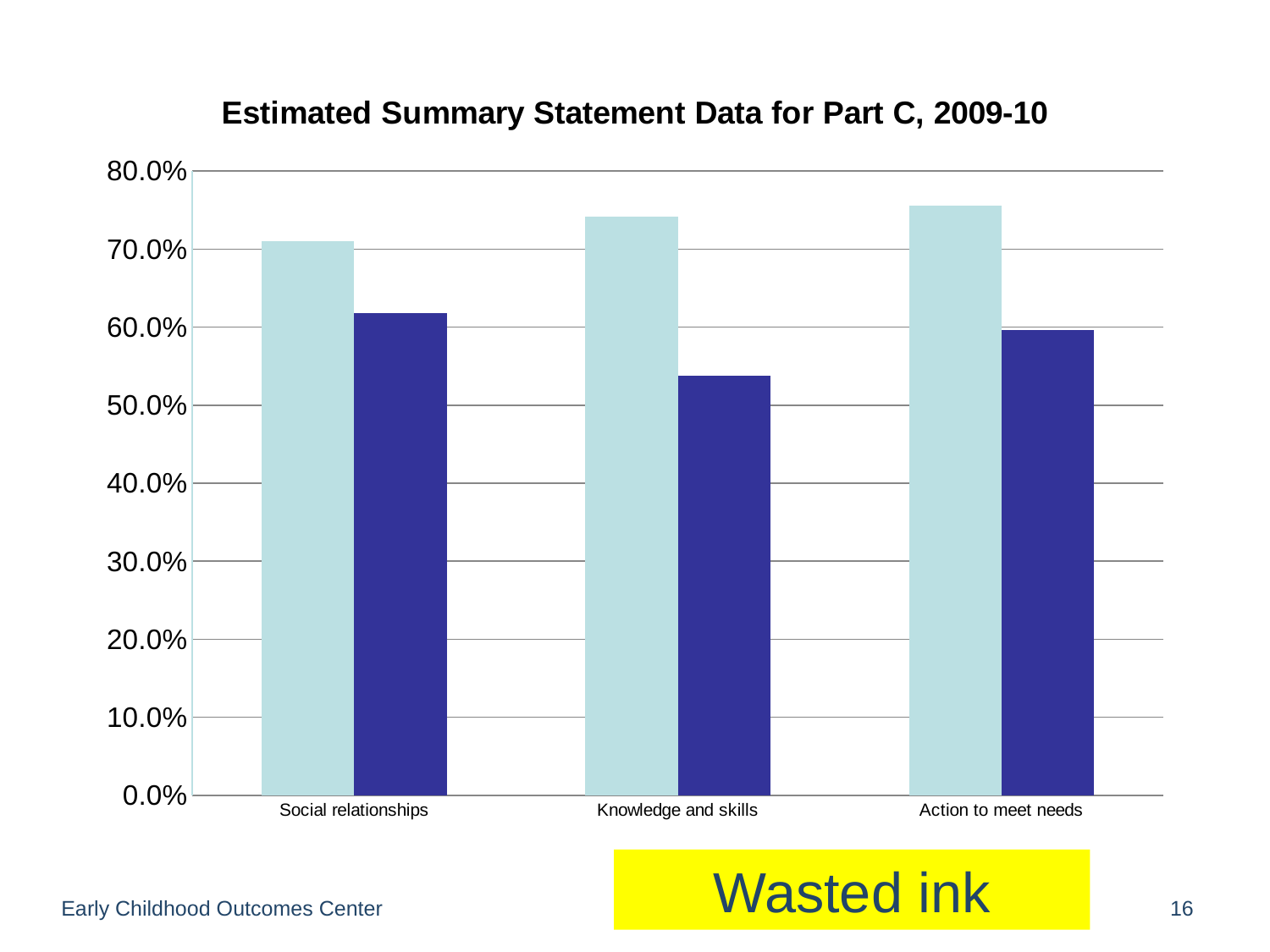
Is the light blue bar for Knowledge and skills greater or less than 70.0%? greater What is the title of the chart? Estimated Summary Statement Data for Part C, 2009-10 For Knowledge and skills, which bar is taller, the light blue bar or the dark blue bar? The light blue bar Is the dark blue bar for Action to meet needs greater or less than 50.0%? greater How many bars are plotted for each category in the chart? 2 Do the light blue bars rise or fall from Social relationships to Action to meet needs? Rise Is the light blue bar for Action to meet needs greater or less than 70.0%? greater What kind of chart is shown on the slide? Bar chart Which category has the lowest dark blue bar? Knowledge and skills Which category has the lowest light blue bar? Social relationships How many categories are shown on the x axis of the chart? 3